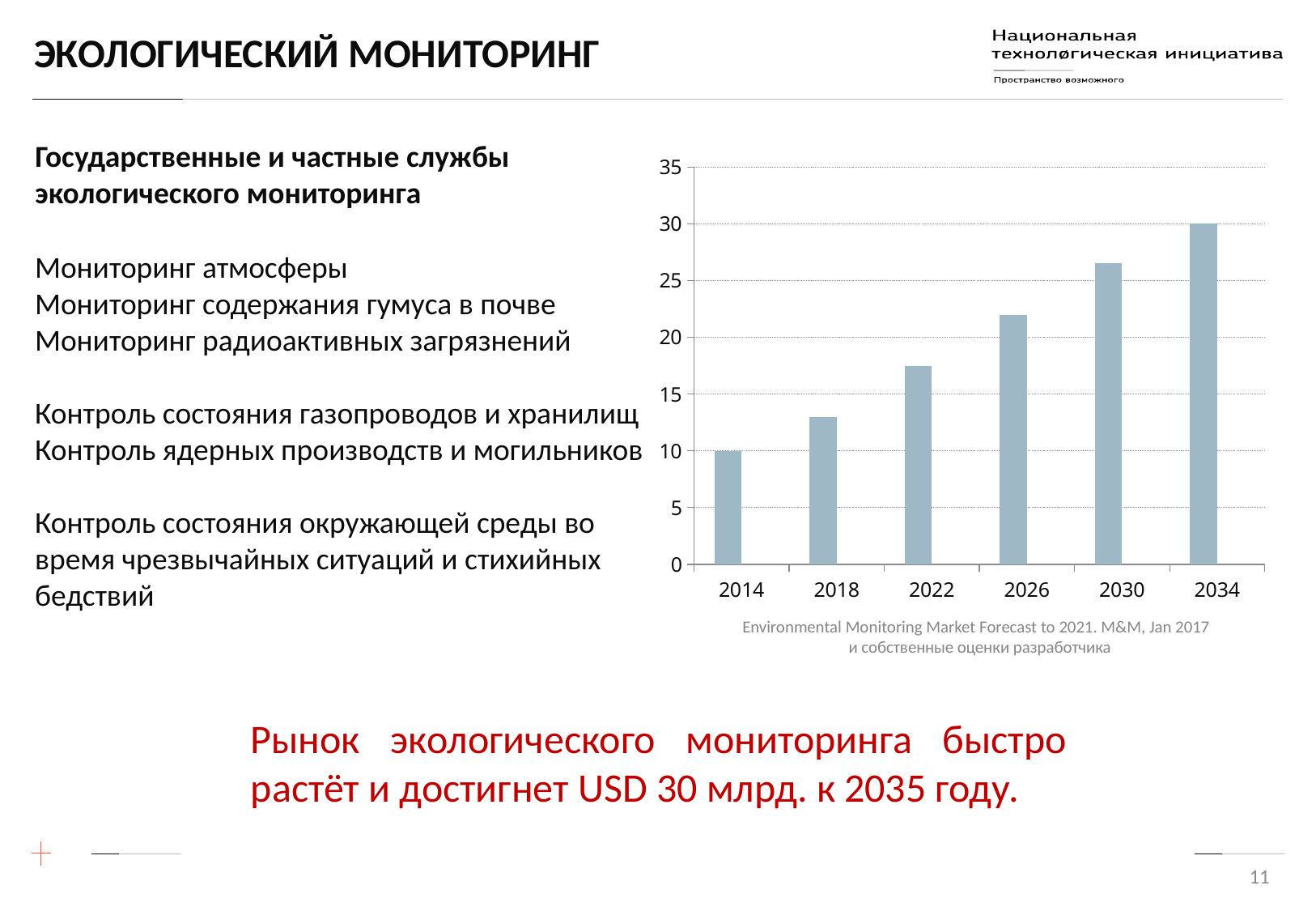
Is the value for 2026 greater or less than 20? greater What is the difference between the values for 2034 and 2014? 20 Which year has the highest value on the chart? 2034 Is the value for 2022 greater or less than 15? greater How many years (bars) are shown on the chart? 6 Do the values rise or fall from 2014 to 2034? rise Is the value for 2018 greater or less than 15? less What is the value for 2034? 30 What type of chart is shown on the slide? bar chart Which is larger, the value for 2030 or the value for 2022? 2030 Which year has the lowest value on the chart? 2014 What is the value for 2014? 10